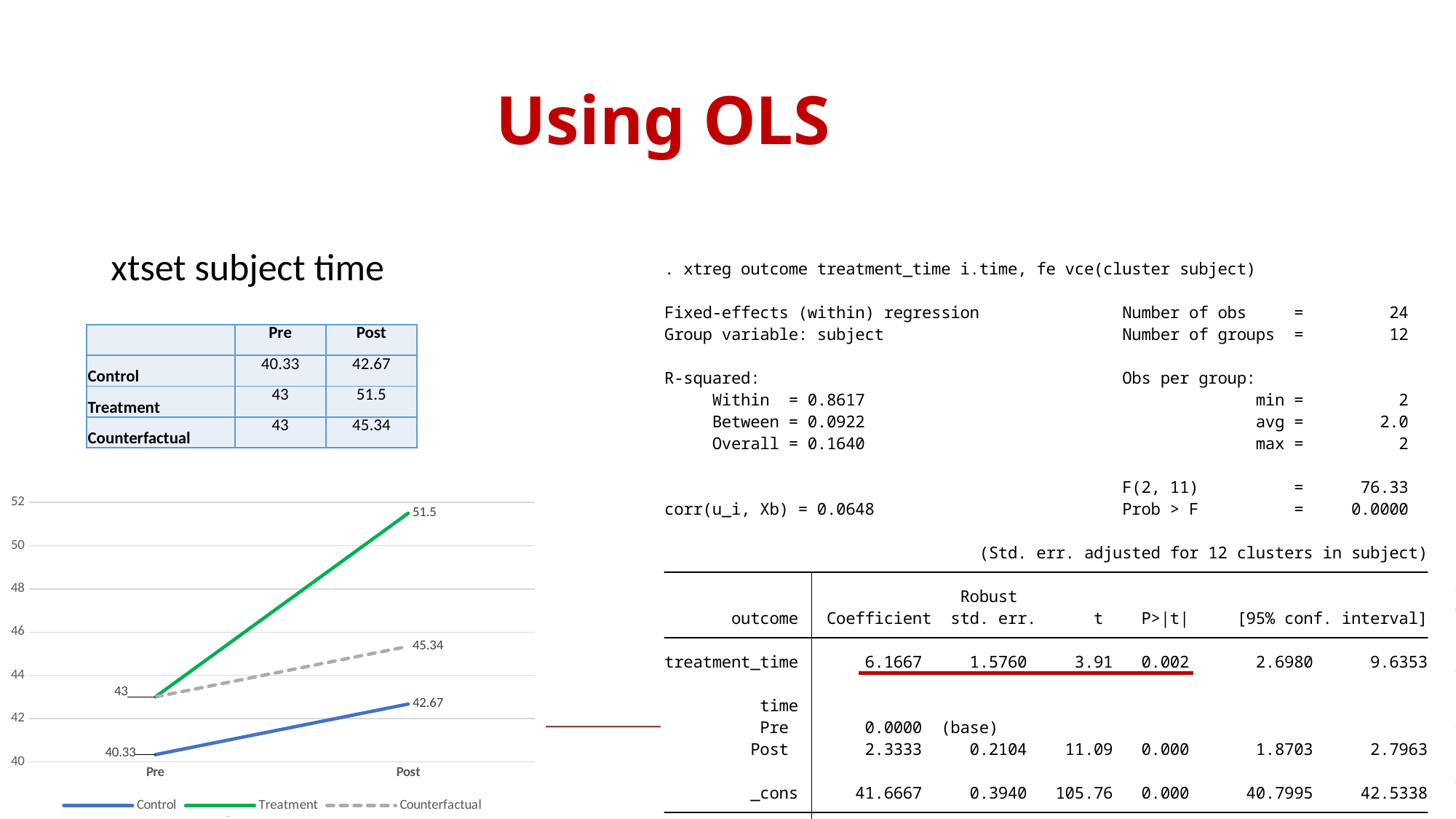
Which series is drawn with a dashed line? Counterfactual Does the Control series rise or fall from Pre to Post? rise Which series has the lowest value at Post? Control What is the Pre value for the Control series? 40.33 Which series has the highest value at Post? Treatment Is the Post value for Counterfactual greater or less than 44? greater What is the Post value for the Counterfactual series? 45.34 What is the difference between the Treatment and Counterfactual values at Post? 6.16 What is the Post value for the Treatment series? 51.5 What is the Post value for the Control series? 42.67 How many series does the chart legend list? 3 What type of chart is shown on the slide? line chart